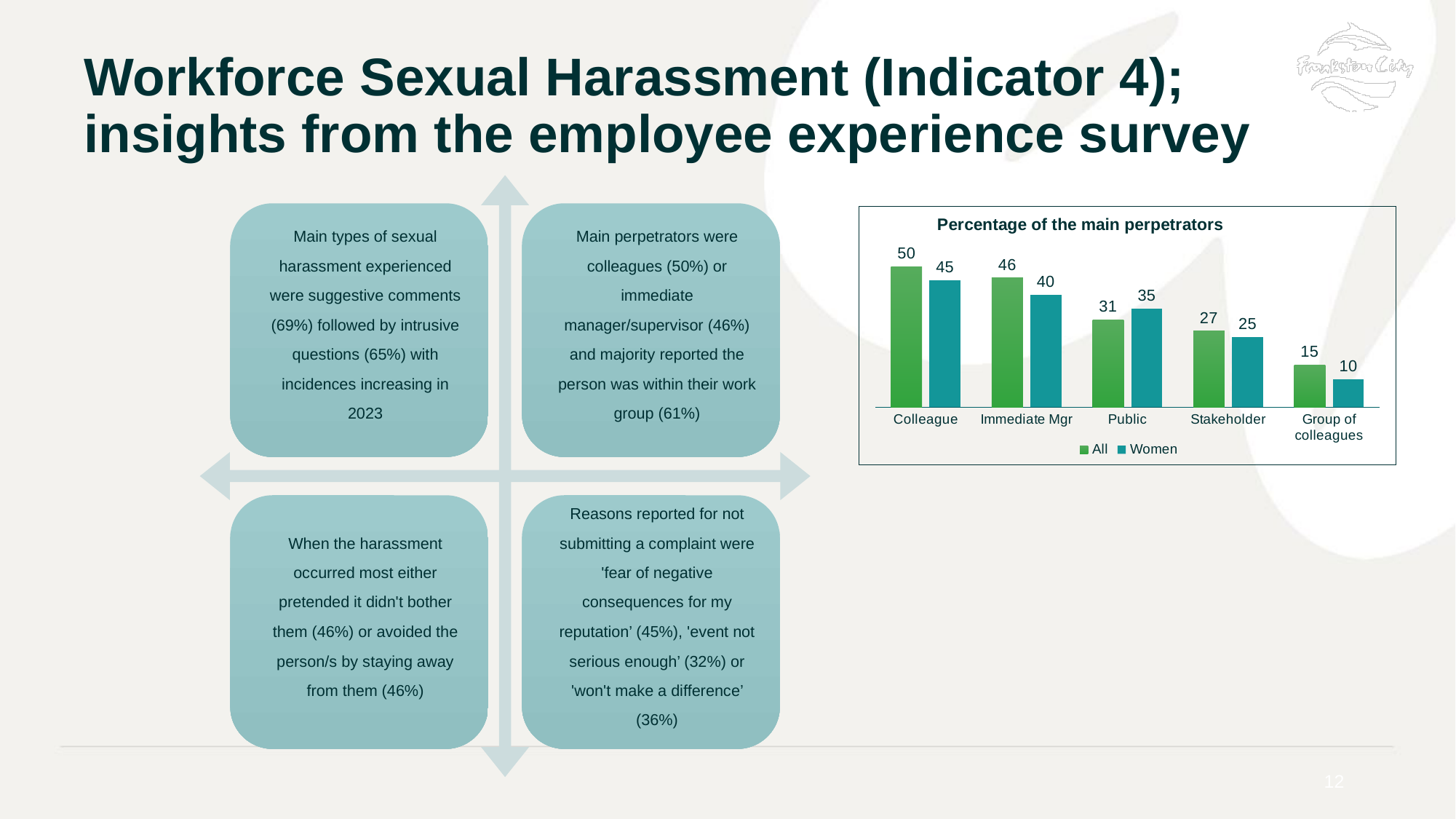
Do the All values rise or fall from Colleague to Group of colleagues? Fall What is the title of the chart? Percentage of the main perpetrators What is the value for All for Colleague? 50 How many series does the legend list? 2 What kind of chart is shown on the slide? Bar chart How many categories are shown on the x axis? 5 Which category has the highest value for the All series? Colleague What is the value for Women for Public? 35 For Public, which series has the larger value, All or Women? Women Which category has the lowest value for the Women series? Group of colleagues What is the value for Women for Group of colleagues? 10 What is the difference between the All and Women values for Immediate Mgr? 6